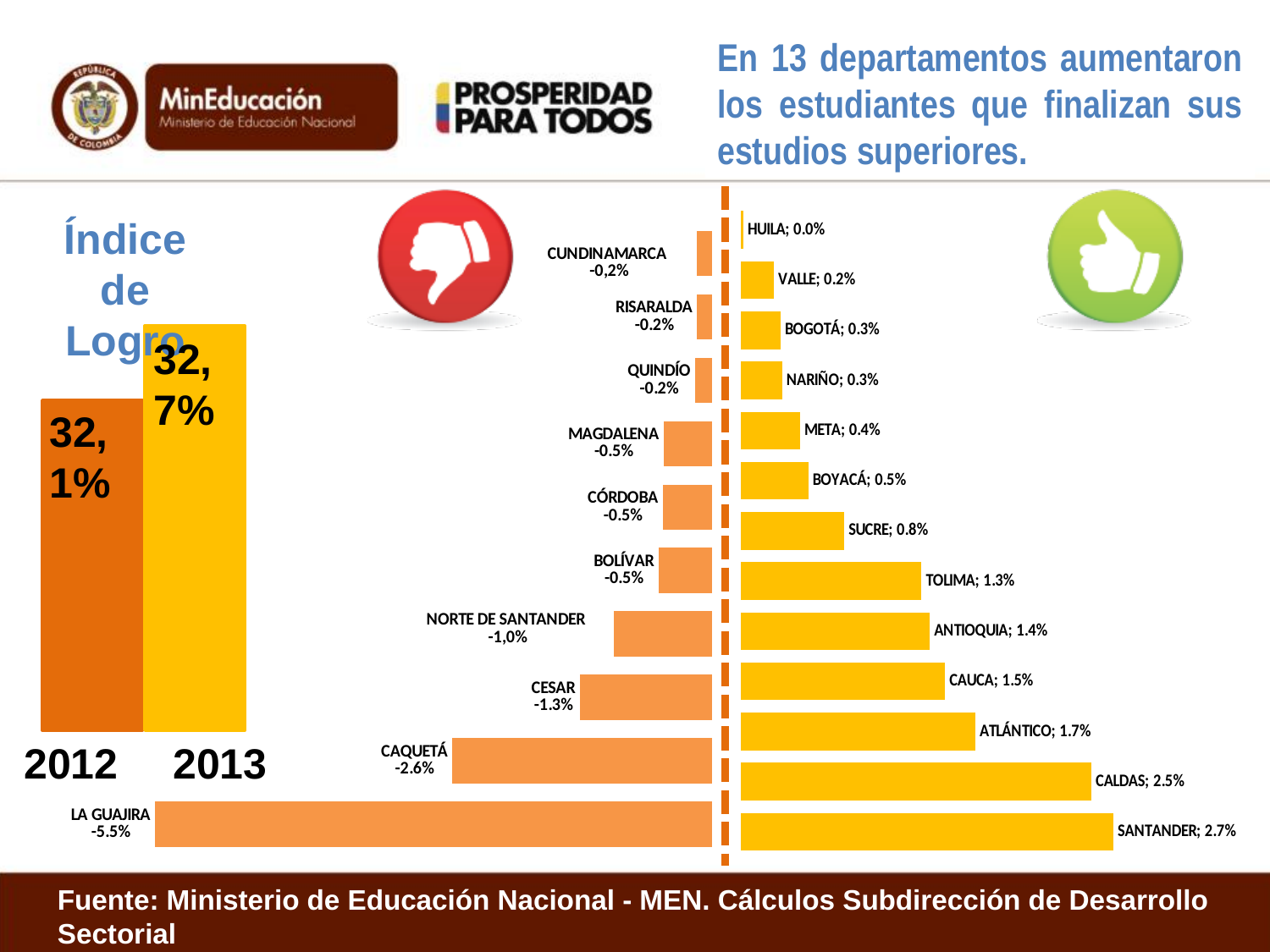
On the department chart on the right, what is the value for Huila? 0.0% On the department chart on the right, which department has the lowest value? La Guajira On the department chart on the right, which department has the highest value? Santander On the department chart on the right, what is the difference between the values for Santander and Caldas? 0.2 percentage points On the department chart on the right, what is the value for La Guajira? -5.5% On the 'Índice de Logro' chart on the left, what is the value for 2012? 32,1% On the department chart on the right, how many departments are shown? 23 On the 'Índice de Logro' chart on the left, what is the value for 2013? 32,7% On the department chart on the right, which has the larger value, Tolima or Antioquia? Antioquia On the 'Índice de Logro' chart on the left, which year has the higher value, 2012 or 2013? 2013 On the department chart on the right, what is the value for Santander? 2.7% What kind of chart is the 'Índice de Logro' chart on the left? bar chart